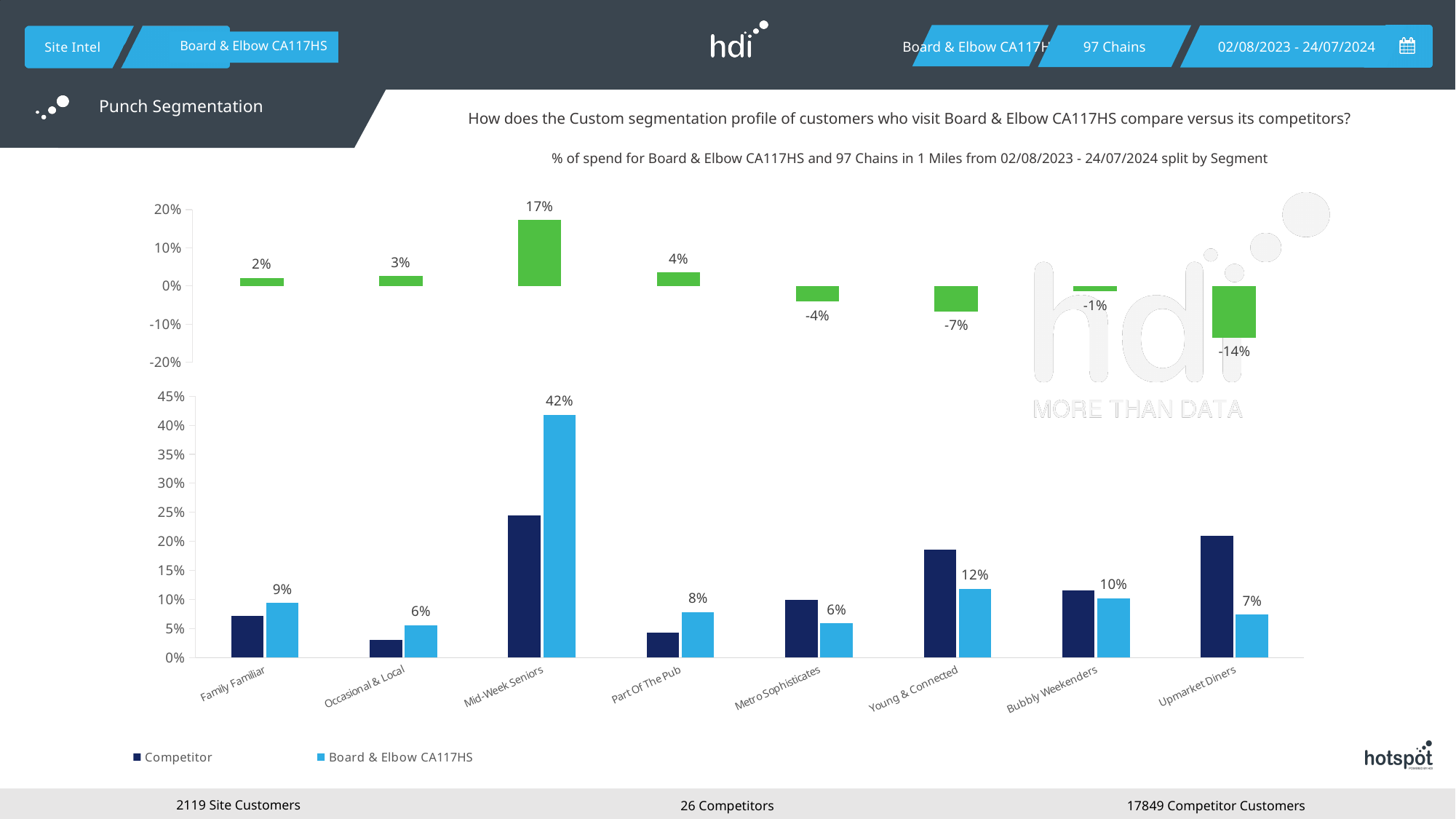
In the bottom chart, which is larger for Upmarket Diners: the Competitor value or the Board & Elbow CA117HS value? Competitor How many series does the legend of the bottom chart list? 2 What type of chart is the bottom chart? Bar chart In the bottom chart, is the Competitor value for Upmarket Diners greater or less than 15%? greater In the bottom chart, what is the difference between the Board & Elbow CA117HS values for Mid-Week Seniors and Family Familiar? 33% In the top chart, which segment has the lowest value? Upmarket Diners In the bottom chart, what is the Board & Elbow CA117HS value for Young & Connected? 12% In the top chart, what is the value for Mid-Week Seniors? 17% In the top chart, what is the value for Upmarket Diners? -14% In the bottom chart, what is the Board & Elbow CA117HS value for Mid-Week Seniors? 42% How many segments are shown on the x axis of the bottom chart? 8 In the top chart, which segment has the highest value? Mid-Week Seniors